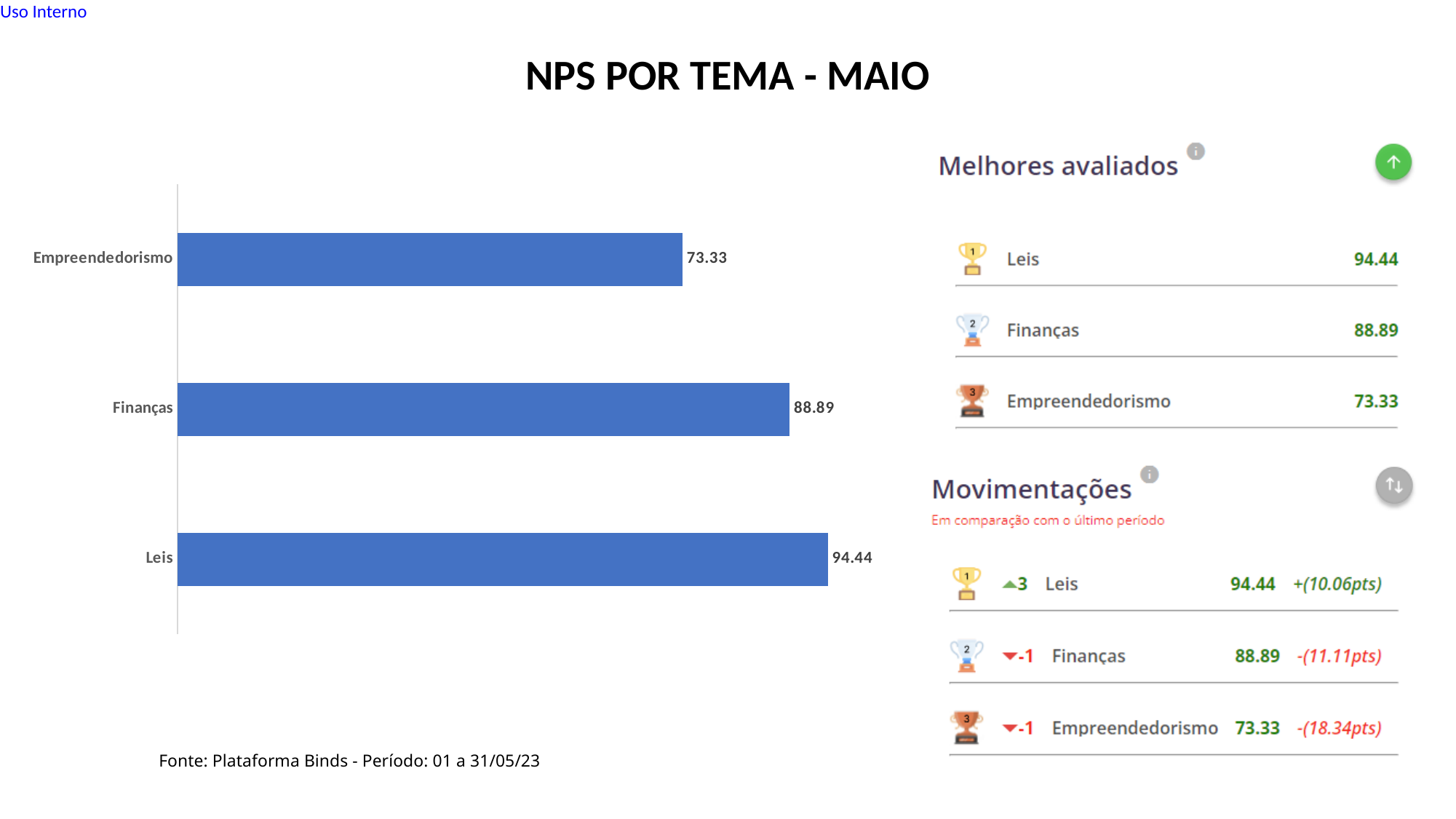
What kind of chart is used to show NPS by theme? Bar chart Which theme has the highest NPS in the bar chart? Leis Which theme has the lowest NPS in the bar chart? Empreendedorismo What is the NPS value for Finanças in the bar chart? 88.89 What is the NPS value for Leis in the bar chart? 94.44 How many themes are shown in the bar chart? 3 Which has a higher NPS, Finanças or Empreendedorismo? Finanças What is the difference between the NPS for Leis and the NPS for Empreendedorismo? 21.11 What is the title of the slide's chart? NPS POR TEMA - MAIO What is the difference between the NPS for Finanças and the NPS for Empreendedorismo? 15.56 What is the NPS value for Empreendedorismo in the bar chart? 73.33 What colour are the bars in the chart? Blue